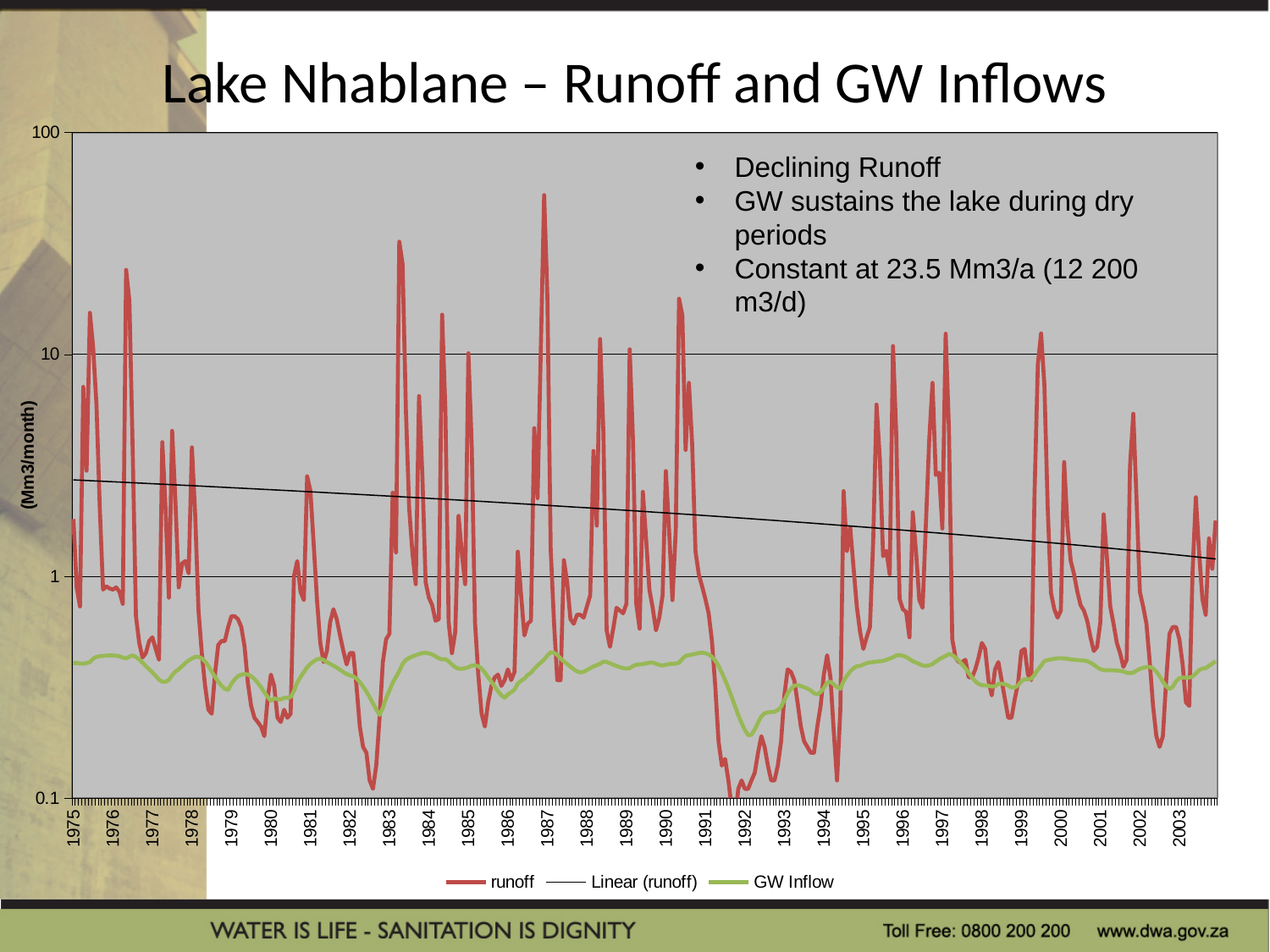
At the start of 1992, which series has the lower value, runoff or GW Inflow? runoff At the 1987 peak, which series has the higher value, runoff or GW Inflow? runoff Is the peak runoff value in 1987 greater or less than 10? greater Is the runoff value at the start of 1992 greater or less than 1? less Is the GW Inflow value in 1990 greater or less than 1? less What are the three series named in the legend? runoff, Linear (runoff), GW Inflow Does the Linear (runoff) trend line rise or fall from 1975 to 2003? fall How many series does the legend list? 3 What is the title of the chart? Lake Nhablane – Runoff and GW Inflows What kind of chart is shown on the slide? line chart